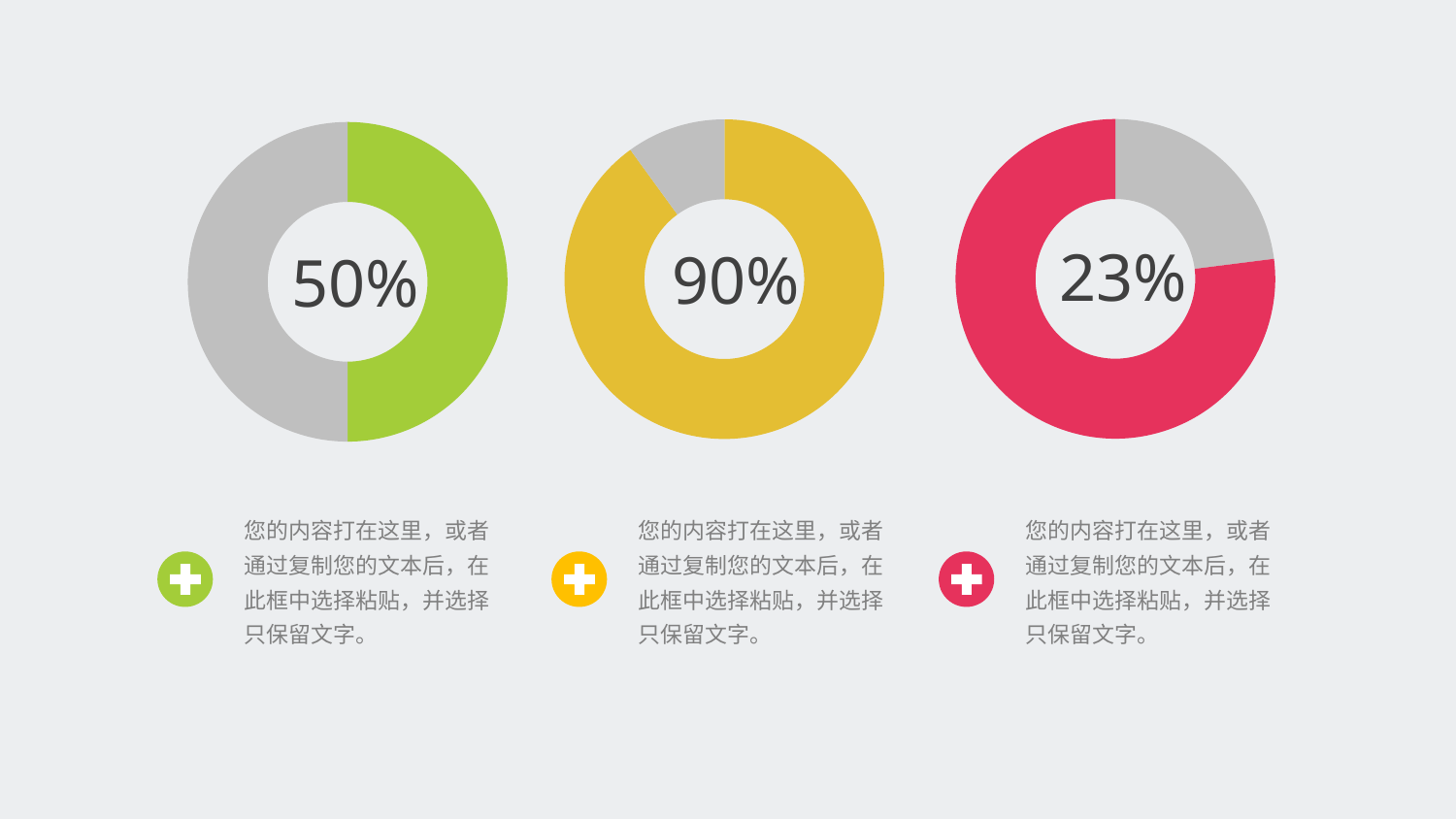
What kind of chart is used on this slide? Donut (pie) chart What is the difference between the percentage shown in the middle donut chart and the percentage shown in the left-hand donut chart? 40% How many donut charts are on the slide? 3 What colour is the coloured segment of the left-hand donut chart? Green Which of the three donut charts shows the lowest percentage in its centre? The right-hand chart (23%) Which of the three donut charts shows the highest percentage in its centre? The middle chart (90%) Which shows a larger percentage, the left-hand donut chart or the right-hand donut chart? The left-hand chart What colour is the coloured segment of the right-hand donut chart? Red What percentage is shown in the centre of the left-hand donut chart? 50% What percentage is shown in the centre of the middle donut chart? 90% What percentage is shown in the centre of the right-hand donut chart? 23% What is the difference between the percentage shown in the left-hand donut chart and the percentage shown in the right-hand donut chart? 27%